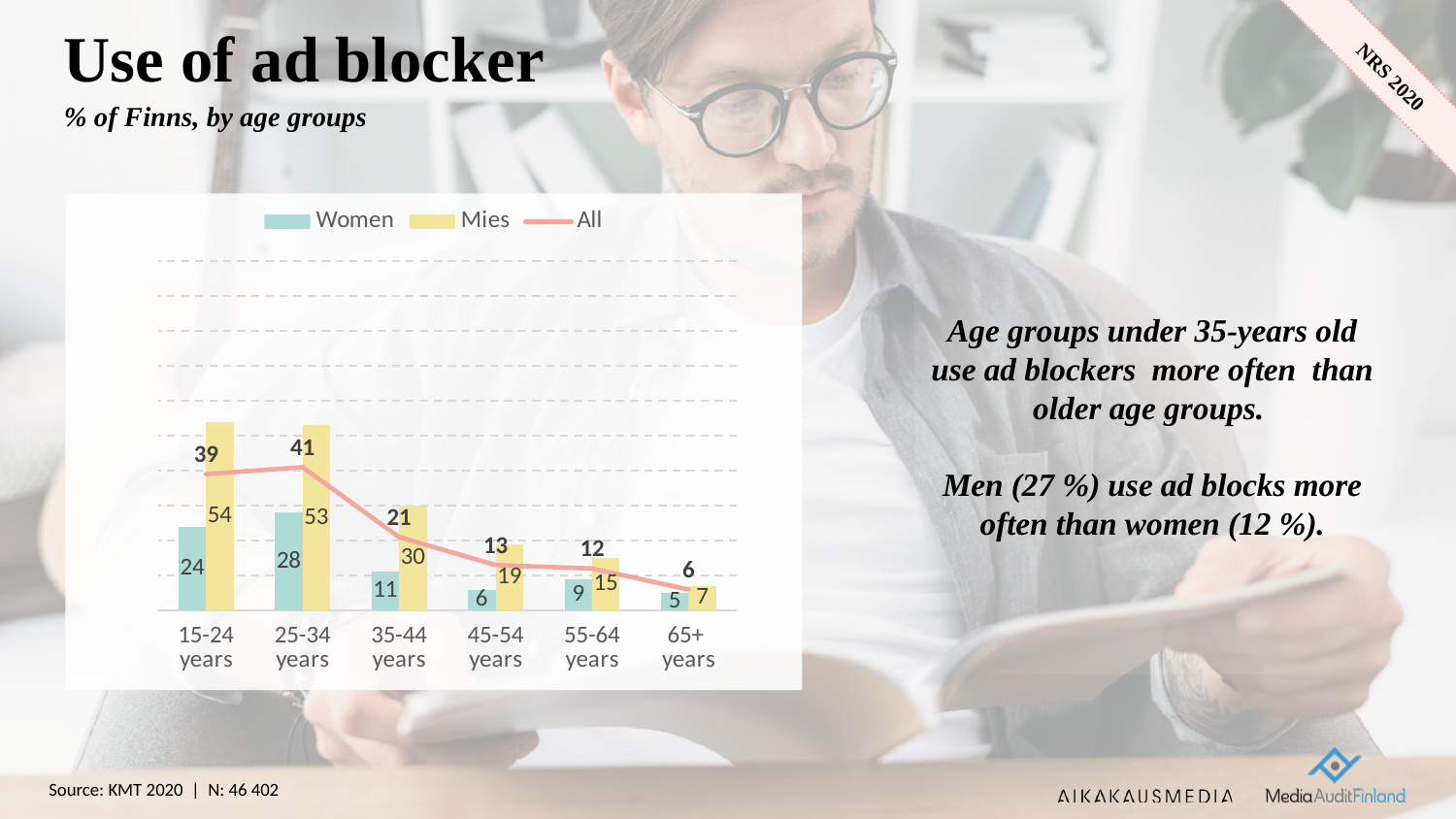
Which age group has the highest value for Mies? 15-24 years Which age group has the lowest value for Women? 65+ years What is the value of the All line for the 35-44 years age group? 21 Which is larger in the 55-64 years age group, the Women value or the Mies value? Mies What is the value for Mies in the 25-34 years age group? 53 How many age groups are shown on the x axis? 6 Does the All line rise or fall from the 25-34 years group to the 65+ years group? Fall What kind of chart is shown on the slide? Bar chart with a line How many series does the legend list? 3 Which series is shown as a line rather than bars? All What is the difference between the Mies and Women values in the 15-24 years age group? 30 What is the value for Women in the 15-24 years age group? 24